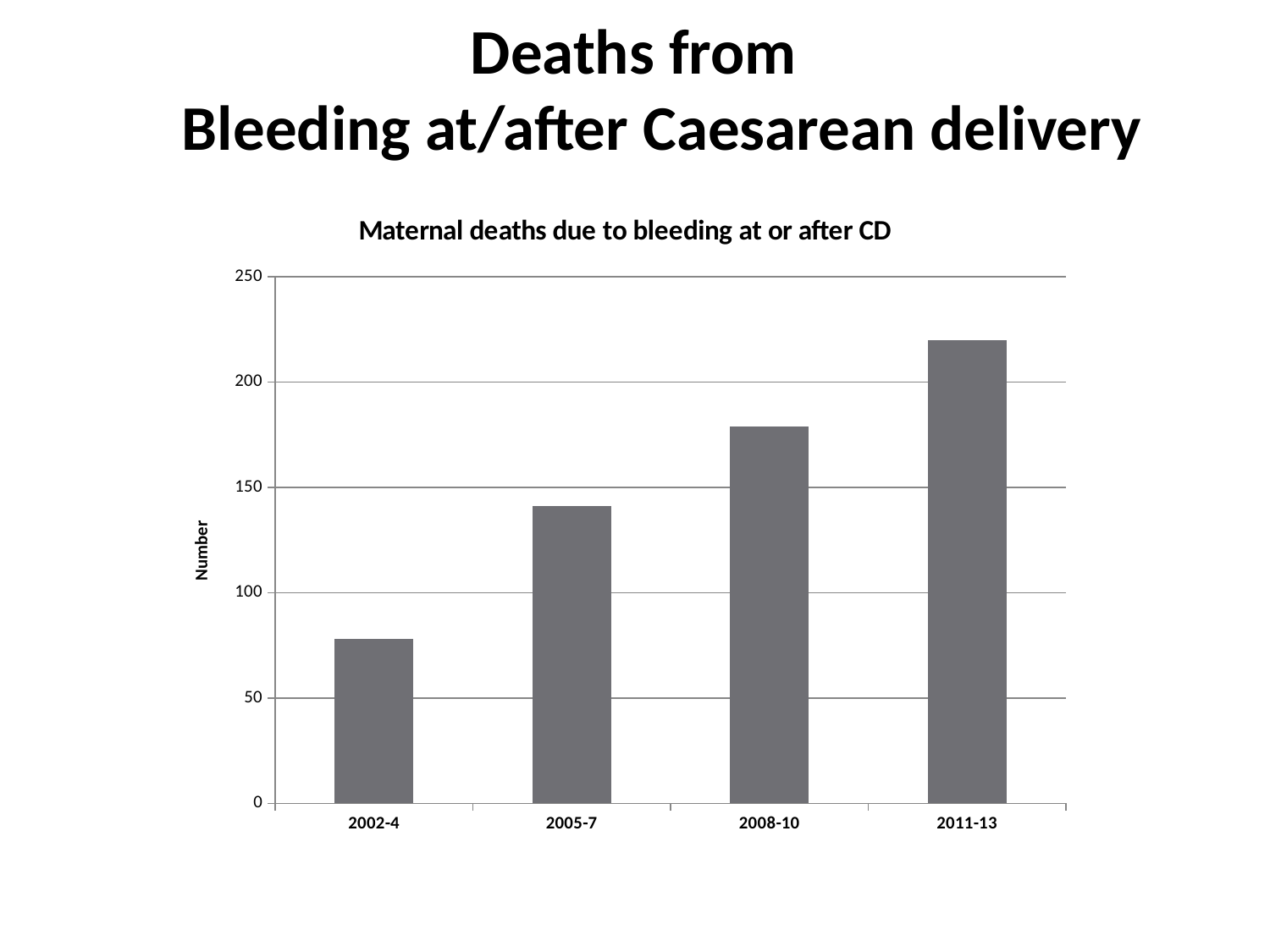
What is the title of the chart? Maternal deaths due to bleeding at or after CD Is the value for 2011-13 greater or less than 200? greater How many time periods are shown on the x axis of the chart? 4 Which is larger, the value for 2005-7 or the value for 2008-10? 2008-10 Is the value for 2008-10 greater or less than 150? greater Which period has the lowest number of maternal deaths due to bleeding at or after CD? 2002-4 Do the values rise or fall from 2002-4 to 2011-13? rise Is the value for 2002-4 greater or less than 50? greater What kind of chart is shown on the slide? bar chart Which period has the highest number of maternal deaths due to bleeding at or after CD? 2011-13